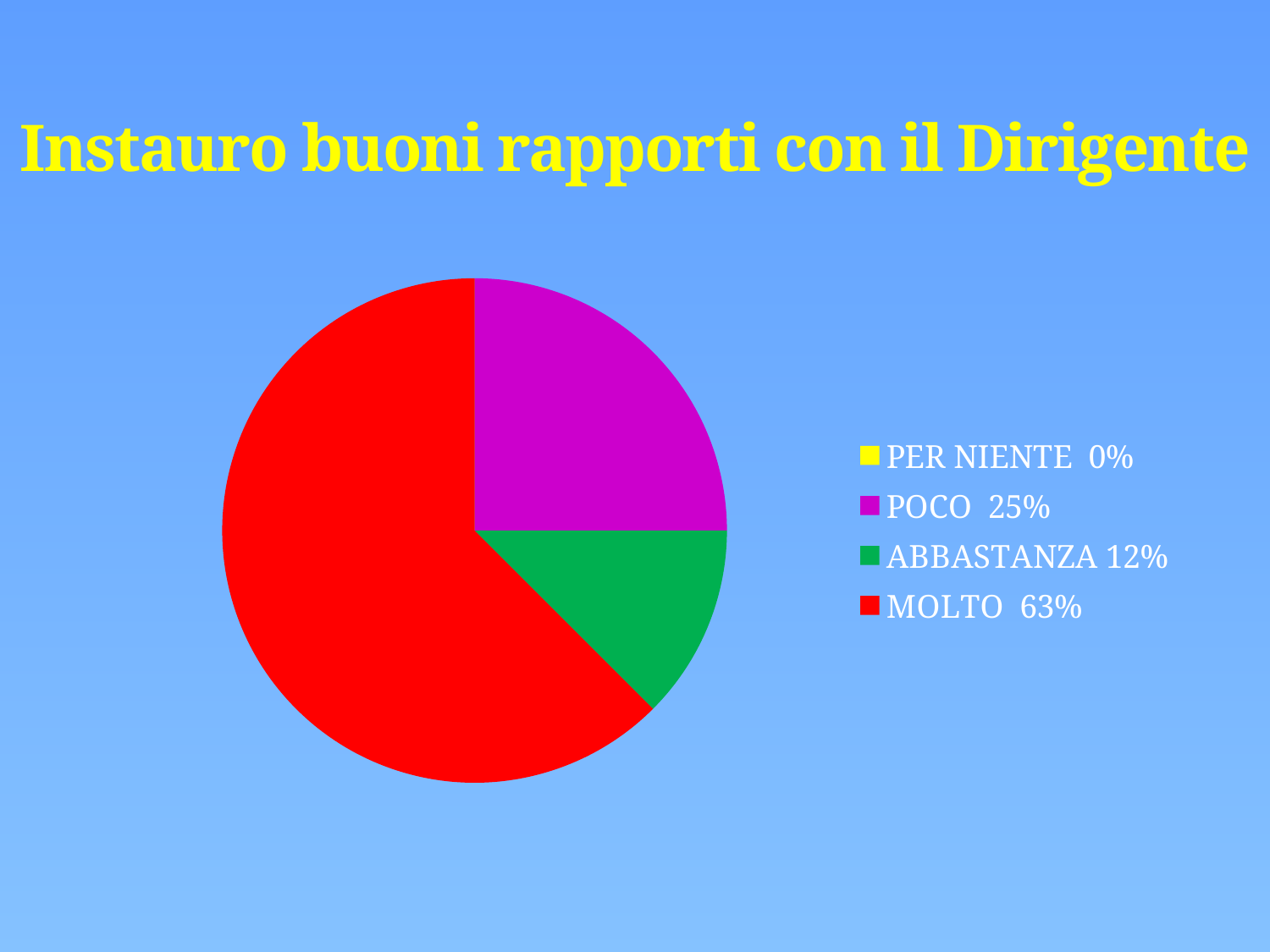
What is the value for MOLTO? 63% Which is larger, the value for POCO or the value for ABBASTANZA? POCO What is the value for ABBASTANZA? 12% What is the difference between the values for MOLTO and POCO? 38% What is the value for PER NIENTE? 0% What is the title of the chart? Instauro buoni rapporti con il Dirigente Which category has the highest value? MOLTO Which category has the lowest value? PER NIENTE What kind of chart is shown on the slide? pie chart What colour is the slice for ABBASTANZA? green How many categories does the legend list? 4 What is the value for POCO? 25%